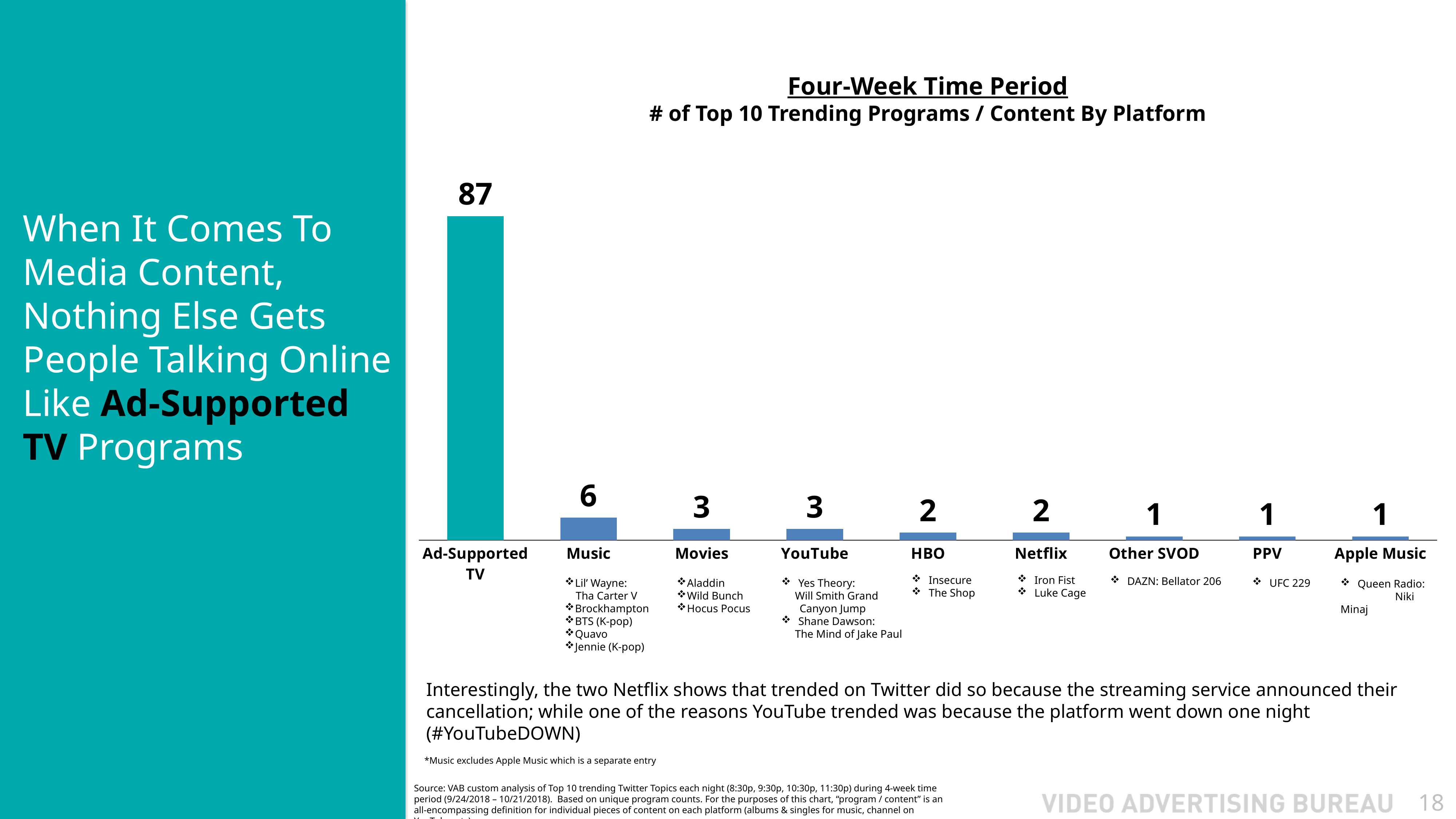
What is the difference between the values for Music and Movies? 3 How many categories are shown in the chart? 9 What is the value for Music? 6 Which category has the highest value? Ad-Supported TV Which is larger, the value for Music or the value for Netflix? Music What is the value for HBO? 2 Do the values rise or fall moving from left to right along the x axis? fall What is the title of the chart? Four-Week Time Period # of Top 10 Trending Programs / Content By Platform What is the value for PPV? 1 What kind of chart is shown on the slide? bar chart What is the difference between the values for Ad-Supported TV and Music? 81 What is the value for Ad-Supported TV? 87